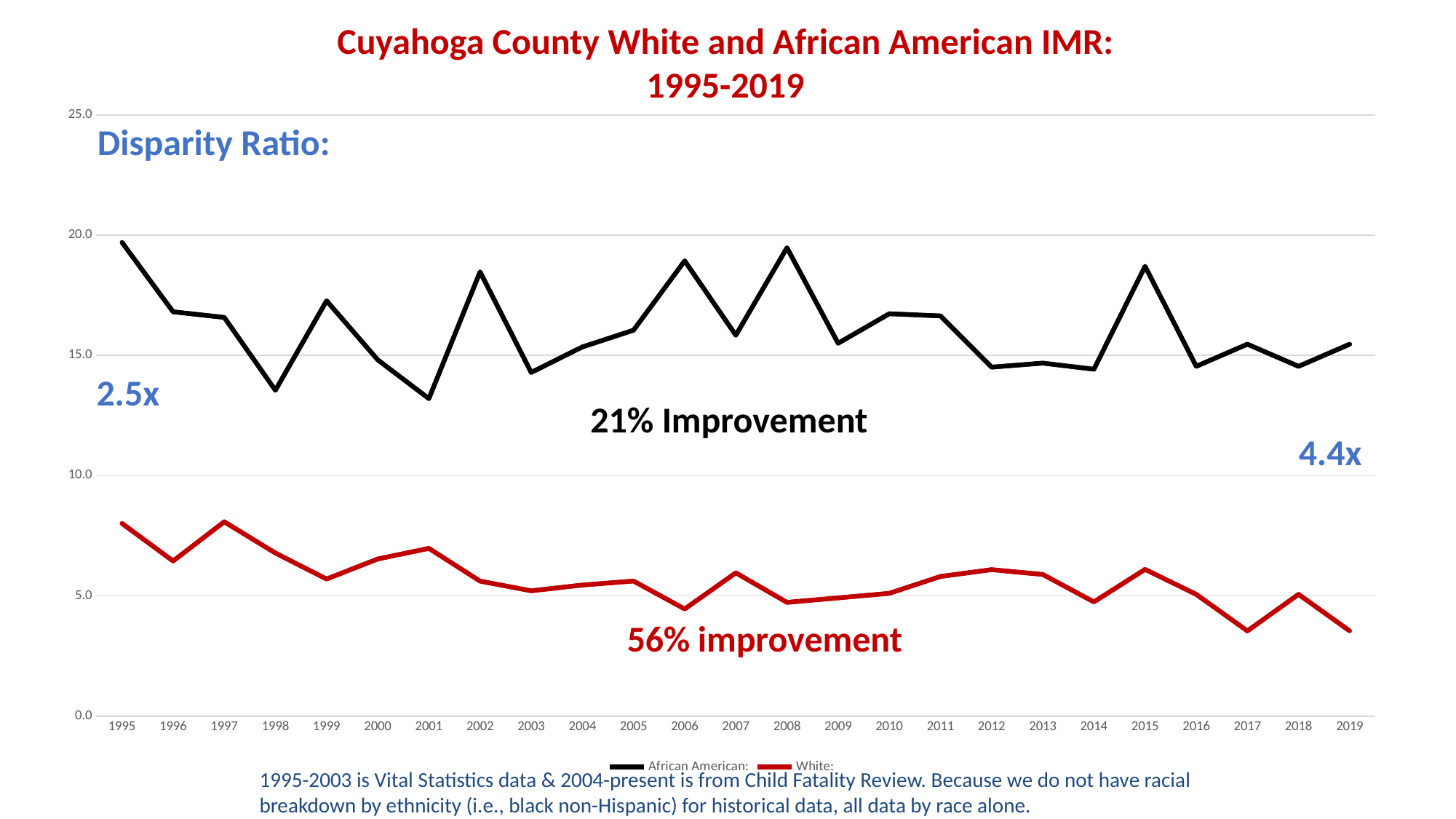
What kind of chart is shown on the slide? line chart Which is larger, the White IMR in 1995 or in 2019? 1995 Is the White IMR value for 1997 greater or less than 5.0? greater What is the title of the chart? Cuyahoga County White and African American IMR: 1995-2019 Is the White IMR value for 2019 greater or less than 5.0? less Which is larger, the African American IMR in 2002 or in 2003? 2002 Is the African American IMR value for 2001 greater or less than 15.0? less Does the White IMR line overall rise or fall from 1995 to 2019? fall How many series does the legend list? 2 How many years are plotted along the x axis? 25 What disparity ratio is annotated at the right end of the chart? 4.4x